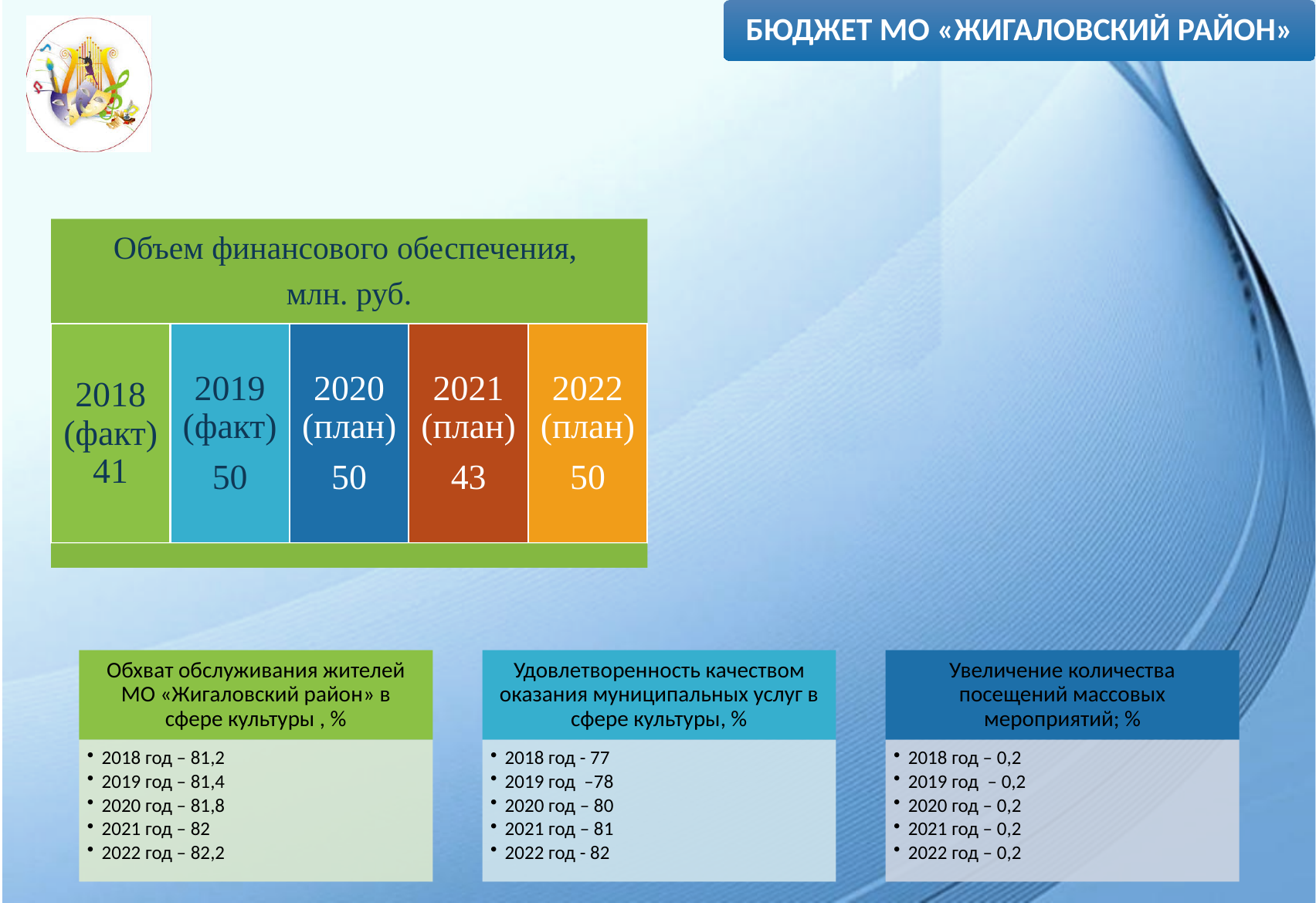
What is the value for 2018 (факт) in the chart "Объем финансового обеспечения, млн. руб."? 41 Which is larger in the chart "Объем финансового обеспечения, млн. руб.": the value for 2021 (план) or the value for 2022 (план)? 2022 (план) What colour is the column for 2021 (план) in the chart "Объем финансового обеспечения, млн. руб."? Brown (dark orange) What is the difference between the values for 2019 (факт) and 2018 (факт) in the chart "Объем финансового обеспечения, млн. руб."? 9 Which year has the lowest value in the chart "Объем финансового обеспечения, млн. руб."? 2018 (факт) How many years are shown in the chart "Объем финансового обеспечения, млн. руб."? 5 What is the difference between the values for 2020 (план) and 2021 (план) in the chart "Объем финансового обеспечения, млн. руб."? 7 What is the value for 2022 (план) in the chart "Объем финансового обеспечения, млн. руб."? 50 What is the title of the chart on the slide? Объем финансового обеспечения, млн. руб. What is the value for 2019 (факт) in the chart "Объем финансового обеспечения, млн. руб."? 50 What is the value for 2021 (план) in the chart "Объем финансового обеспечения, млн. руб."? 43 How many of the years in the chart "Объем финансового обеспечения, млн. руб." are labelled as план? 3